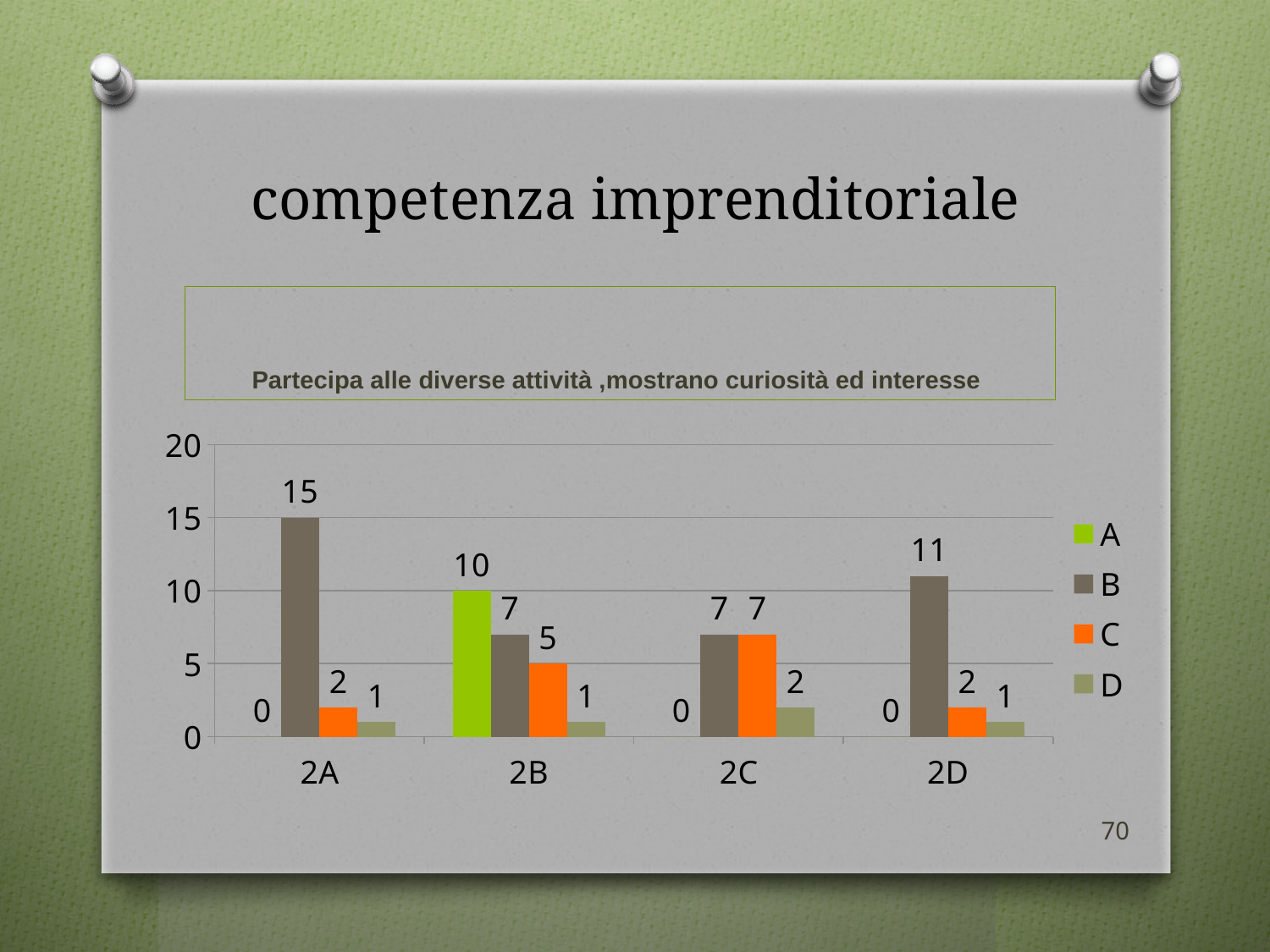
What is the value of series B for category 2A? 15 How many categories are shown on the x axis? 4 Which is larger: series B for 2B or series C for 2B? Series B for 2B What is the value of series A for category 2B? 10 What kind of chart is shown on the slide? Bar chart What is the value of series D for category 2D? 1 How many series does the legend list? 4 What is the difference between the series B values for 2A and 2D? 4 Which category has the highest value for series B? 2A What is the value of series C for category 2C? 7